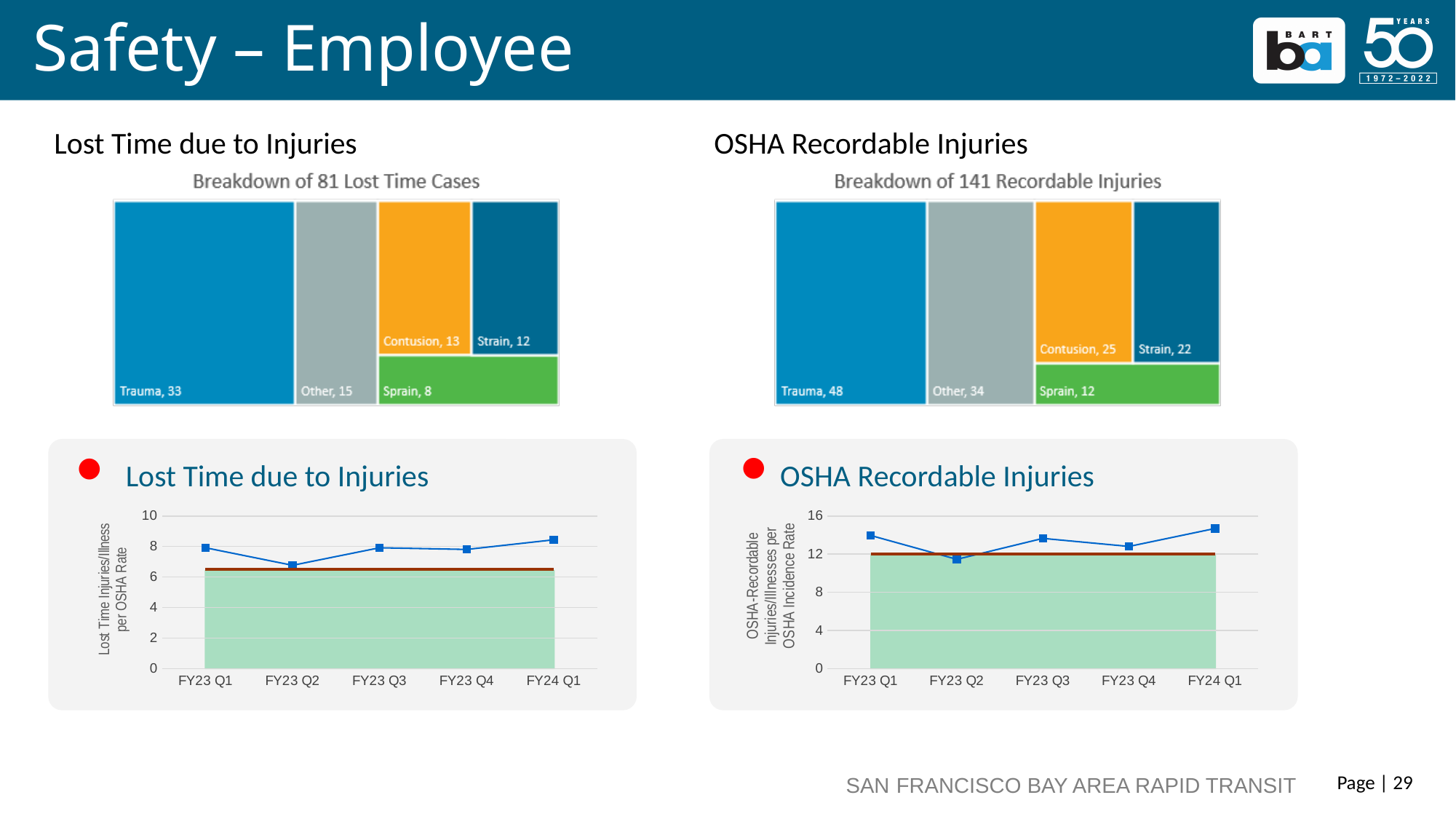
In the 'OSHA Recordable Injuries' line chart, is the value for FY23 Q2 greater or less than 12? less In the 'Breakdown of 141 Recordable Injuries' chart, which is larger, Contusion or Strain? Contusion In the 'Breakdown of 81 Lost Time Cases' chart, how many cases are attributed to Trauma? 33 In the 'Breakdown of 81 Lost Time Cases' chart, which category has the fewest cases? Sprain In the 'Breakdown of 81 Lost Time Cases' chart, how many categories are shown? 5 In the 'Lost Time due to Injuries' line chart, which quarter has the lowest value? FY23 Q2 In the 'Breakdown of 141 Recordable Injuries' chart, which category has the most injuries? Trauma In the 'Breakdown of 141 Recordable Injuries' chart, how many injuries are labelled Other? 34 In the 'Breakdown of 141 Recordable Injuries' chart, what is the difference between Trauma and Other? 14 In the 'Breakdown of 81 Lost Time Cases' chart, what is the difference between the Contusion and Strain counts? 1 In the 'Lost Time due to Injuries' line chart, is the value for FY24 Q1 greater or less than 8? greater In the 'OSHA Recordable Injuries' line chart, how many quarters are plotted on the x axis? 5